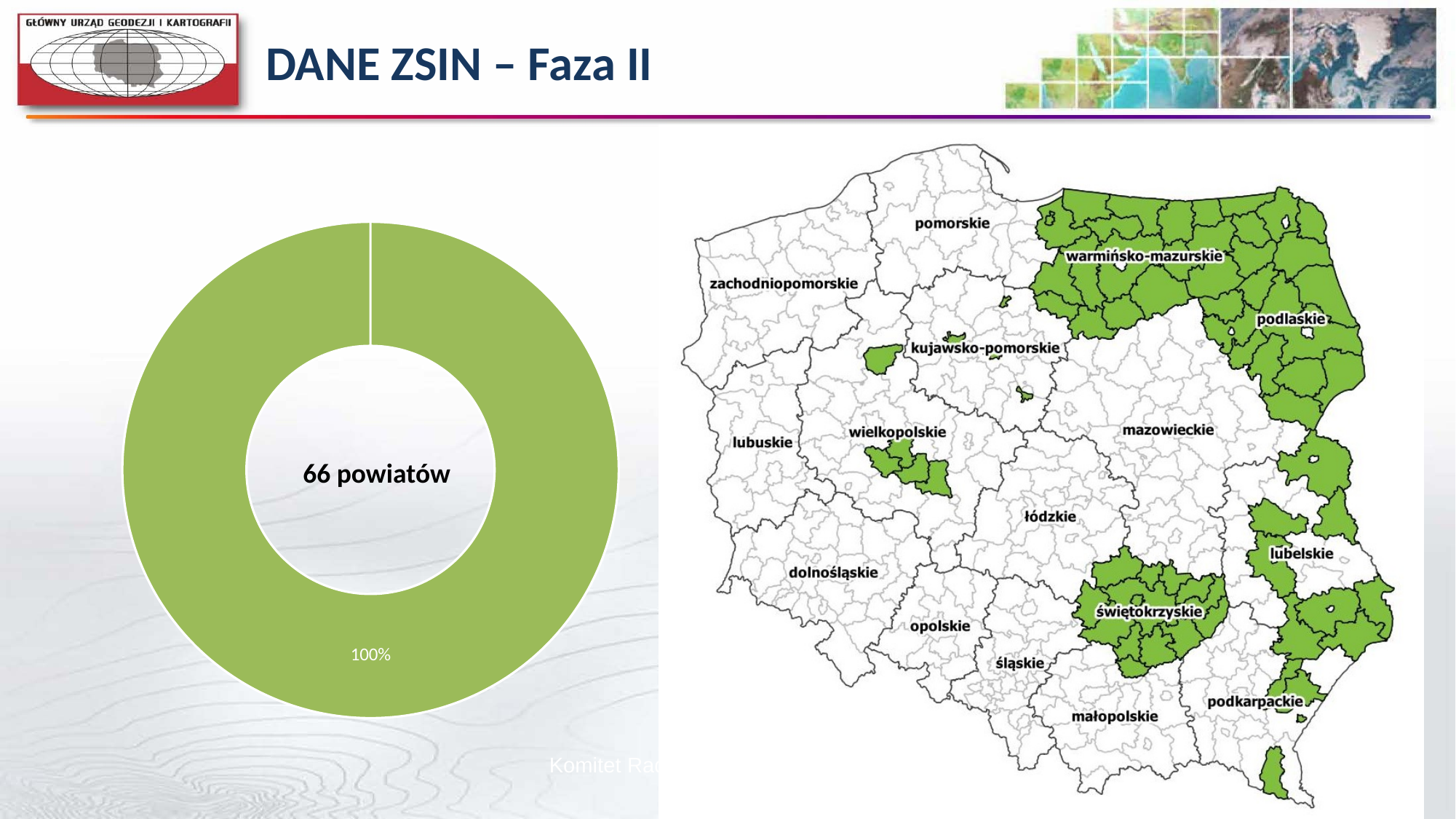
What is the title of the slide containing the doughnut chart? DANE ZSIN – Faza II Is the share shown on the doughnut chart greater or less than 50%? greater What kind of chart is shown on the left side of the slide? doughnut chart How many slices does the doughnut chart contain? 1 What percentage is printed on the single slice of the doughnut chart? 100% What text is displayed in the centre of the doughnut chart? 66 powiatów What colour is the slice of the doughnut chart? green